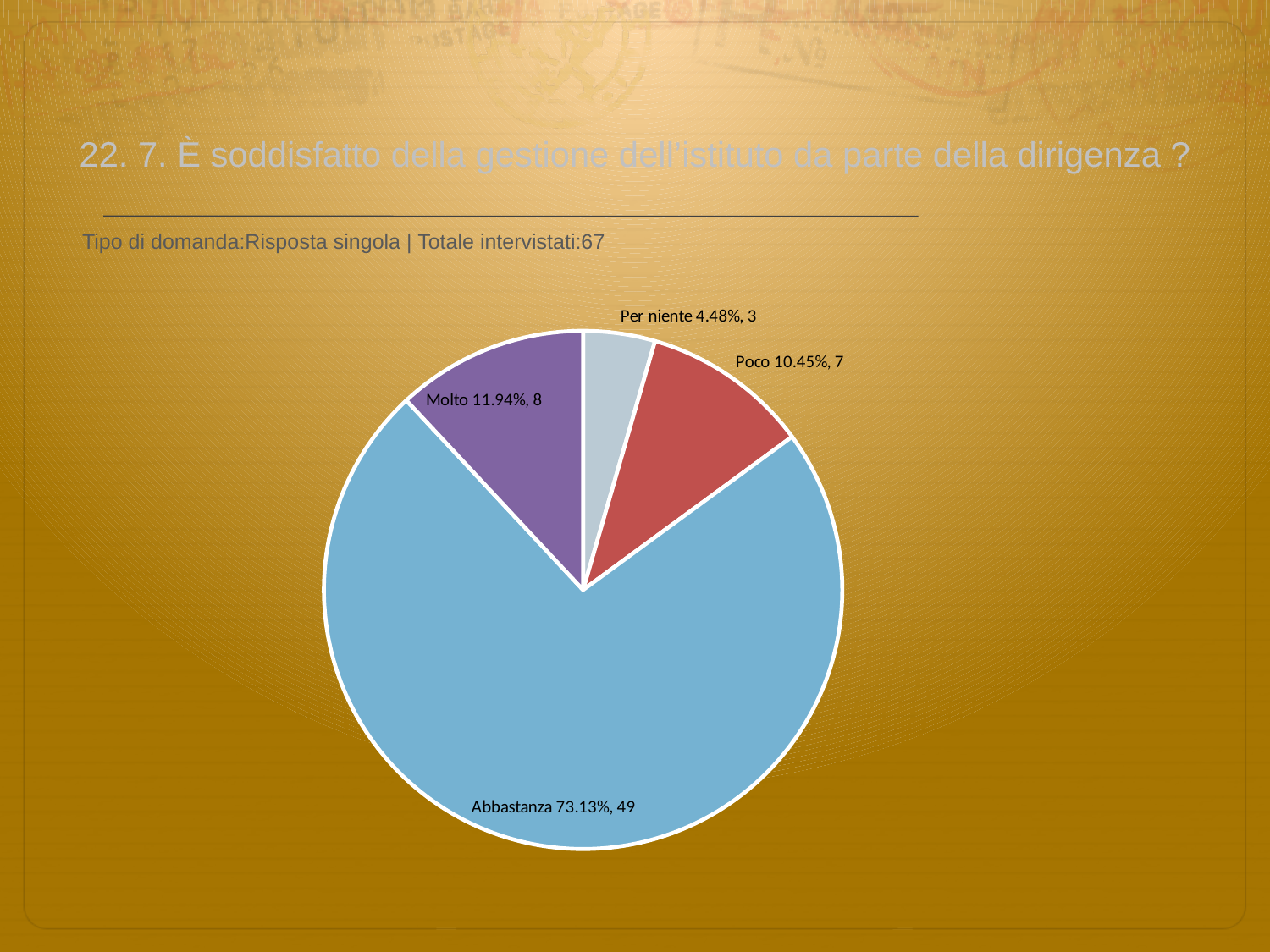
Which category has the smallest slice? Per niente What is the difference in respondent count between Abbastanza and Molto? 41 What percentage share does the Abbastanza slice have? 73.13% What colour is the Abbastanza slice? light blue What is the total number of respondents across all slices? 67 What percentage share does the Per niente slice have? 4.48% How many slices does the pie chart have? 4 Which category has the largest slice? Abbastanza What kind of chart is shown on the slide? pie chart How many respondents answered Poco? 7 Which has more respondents, Molto or Poco? Molto How many respondents answered Molto? 8